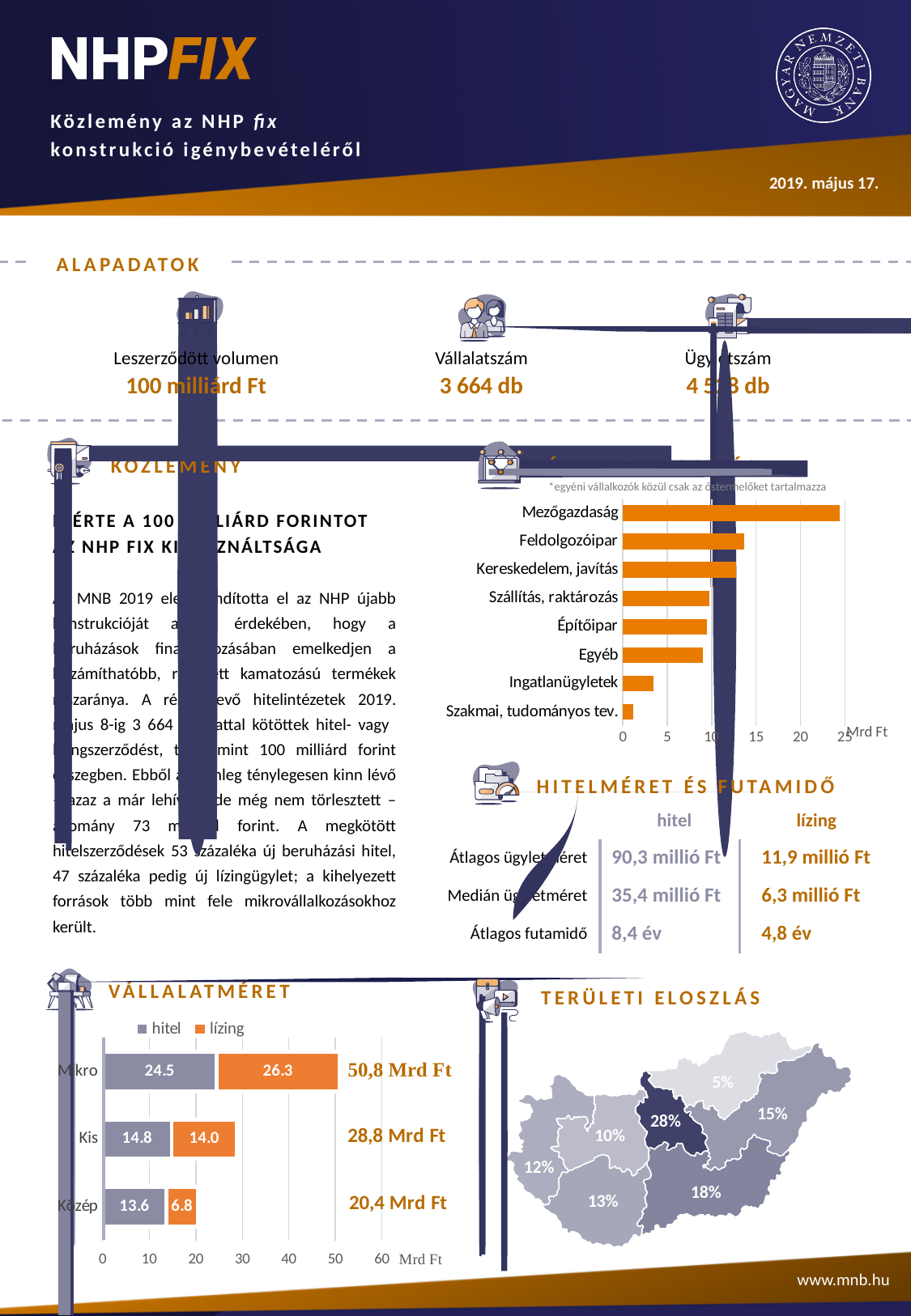
In the Vállalatméret chart, which is larger for Mikro: hitel or lízing? lízing In the sector bar chart on the upper right, which sector has the longest bar? Mezőgazdaság In the sector bar chart on the upper right, how many sectors are listed? 8 In the Vállalatméret chart, what is the difference between the hitel and lízing values for Kis? 0.8 In the Vállalatméret chart, how many series does the legend list? 2 In the Vállalatméret chart, how many company-size categories are shown? 3 In the sector bar chart on the upper right, which sector has the shortest bar? Szakmai, tudományos tev. What kind of chart is the Vállalatméret chart? stacked bar chart In the Vállalatméret chart, what is the lízing value for Közép? 6.8 In the Vállalatméret chart, what is the hitel value for Mikro? 24.5 In the Vállalatméret chart, what is the total shown for the Kis bar? 28,8 Mrd Ft In the sector bar chart on the upper right, is the value for Mezőgazdaság greater or less than 20 Mrd Ft? greater